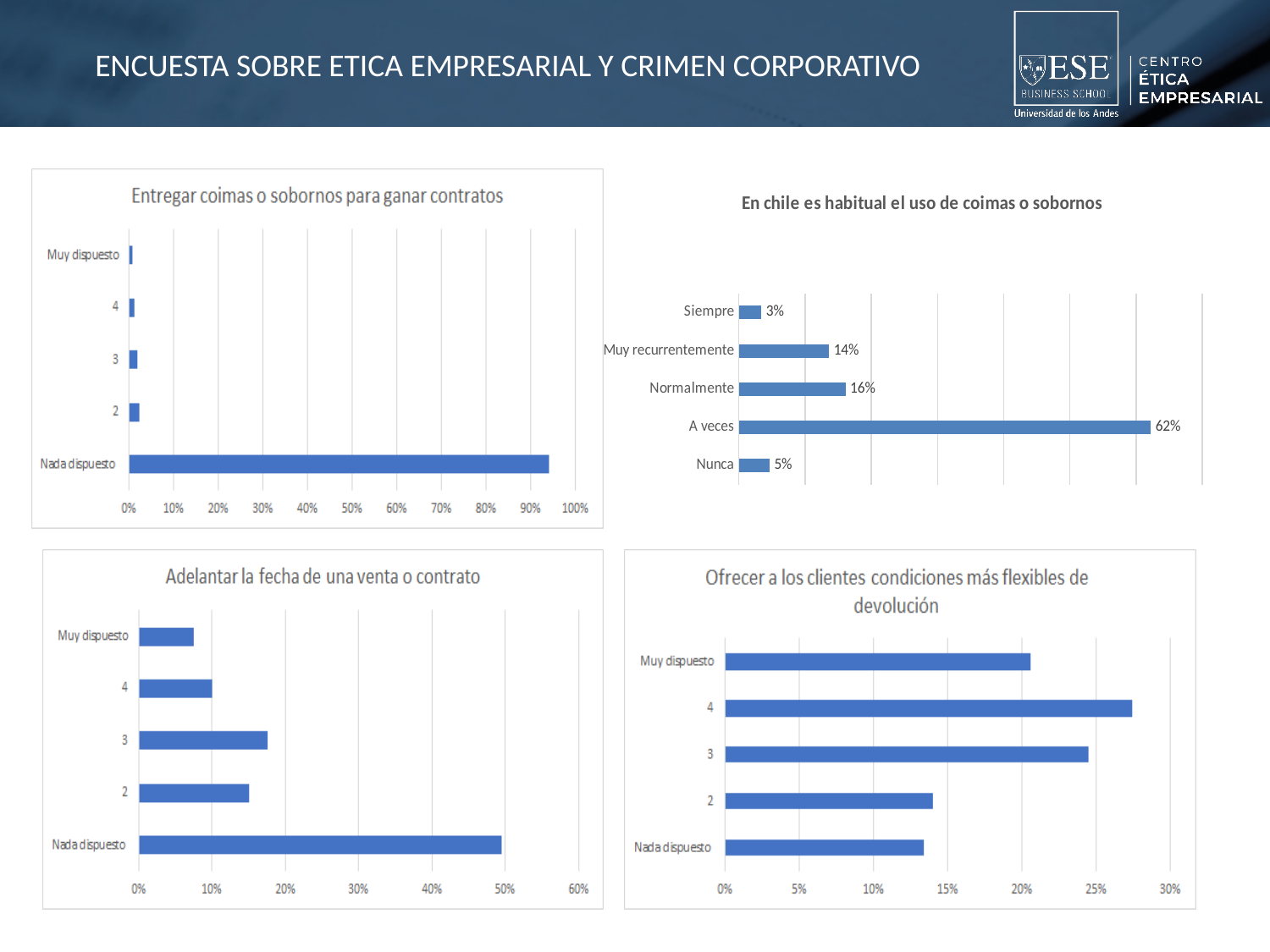
In the chart 'Entregar coimas o sobornos para ganar contratos', is the value for 'Nada dispuesto' greater or less than 90%? greater In the chart 'En chile es habitual el uso de coimas o sobornos', which is larger: 'Normalmente' or 'Nunca'? Normalmente In the chart 'En chile es habitual el uso de coimas o sobornos', what is the difference between 'A veces' and 'Normalmente'? 46% In the chart 'Adelantar la fecha de una venta o contrato', which category has the lowest value? Muy dispuesto In the chart 'Entregar coimas o sobornos para ganar contratos', which category has the highest value? Nada dispuesto What type of chart is 'Ofrecer a los clientes condiciones más flexibles de devolución'? Bar chart In the chart 'En chile es habitual el uso de coimas o sobornos', what is the value for 'A veces'? 62% How many categories are shown in the chart 'En chile es habitual el uso de coimas o sobornos'? 5 In the chart 'Adelantar la fecha de una venta o contrato', is the value for 'Nada dispuesto' greater or less than 40%? greater In the chart 'En chile es habitual el uso de coimas o sobornos', which category has the lowest value? Siempre In the chart 'Ofrecer a los clientes condiciones más flexibles de devolución', which category has the highest value? 4 In the chart 'En chile es habitual el uso de coimas o sobornos', what is the value for 'Muy recurrentemente'? 14%